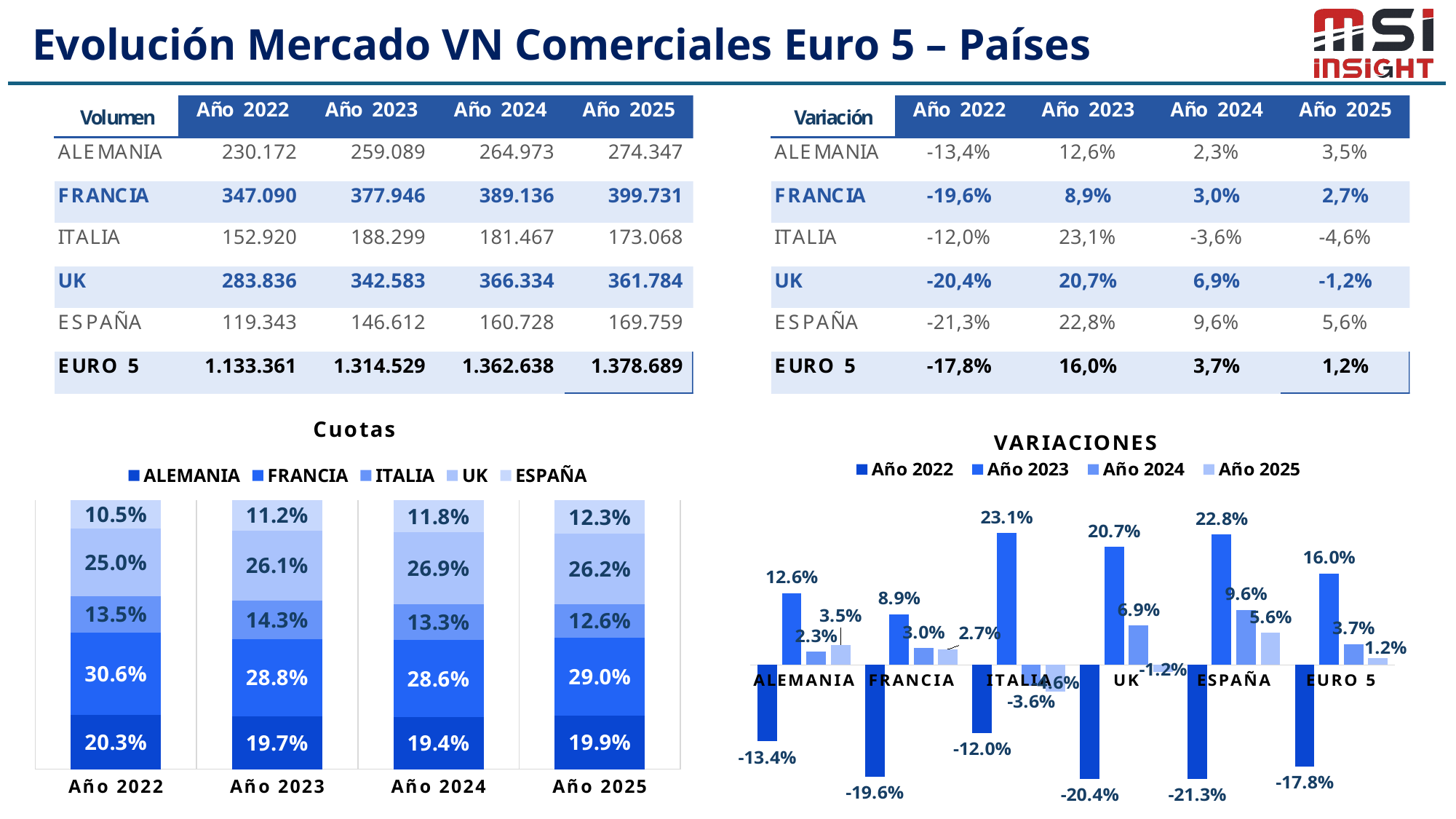
How many series does the legend of the VARIACIONES chart list? 4 In the Cuotas chart, what is the share for FRANCIA in Año 2022? 30.6% In the VARIACIONES chart, which country has the lowest value for Año 2022? ESPAÑA How many series does the legend of the Cuotas chart list? 5 In the VARIACIONES chart, which category has the highest value for Año 2023? ITALIA How many categories are shown on the x axis of the VARIACIONES chart? 6 What kind of chart is the Cuotas chart? Stacked bar chart In the Cuotas chart, what is the difference between the FRANCIA and ALEMANIA shares in Año 2024? 9.2 percentage points In the Cuotas chart, what is the share for ESPAÑA in Año 2025? 12.3% In the VARIACIONES chart, which is larger for Año 2023: ALEMANIA or FRANCIA? ALEMANIA In the Cuotas chart, does the share for ESPAÑA rise or fall from Año 2022 to Año 2025? Rise In the VARIACIONES chart, what is the value for ITALIA in Año 2023? 23.1%